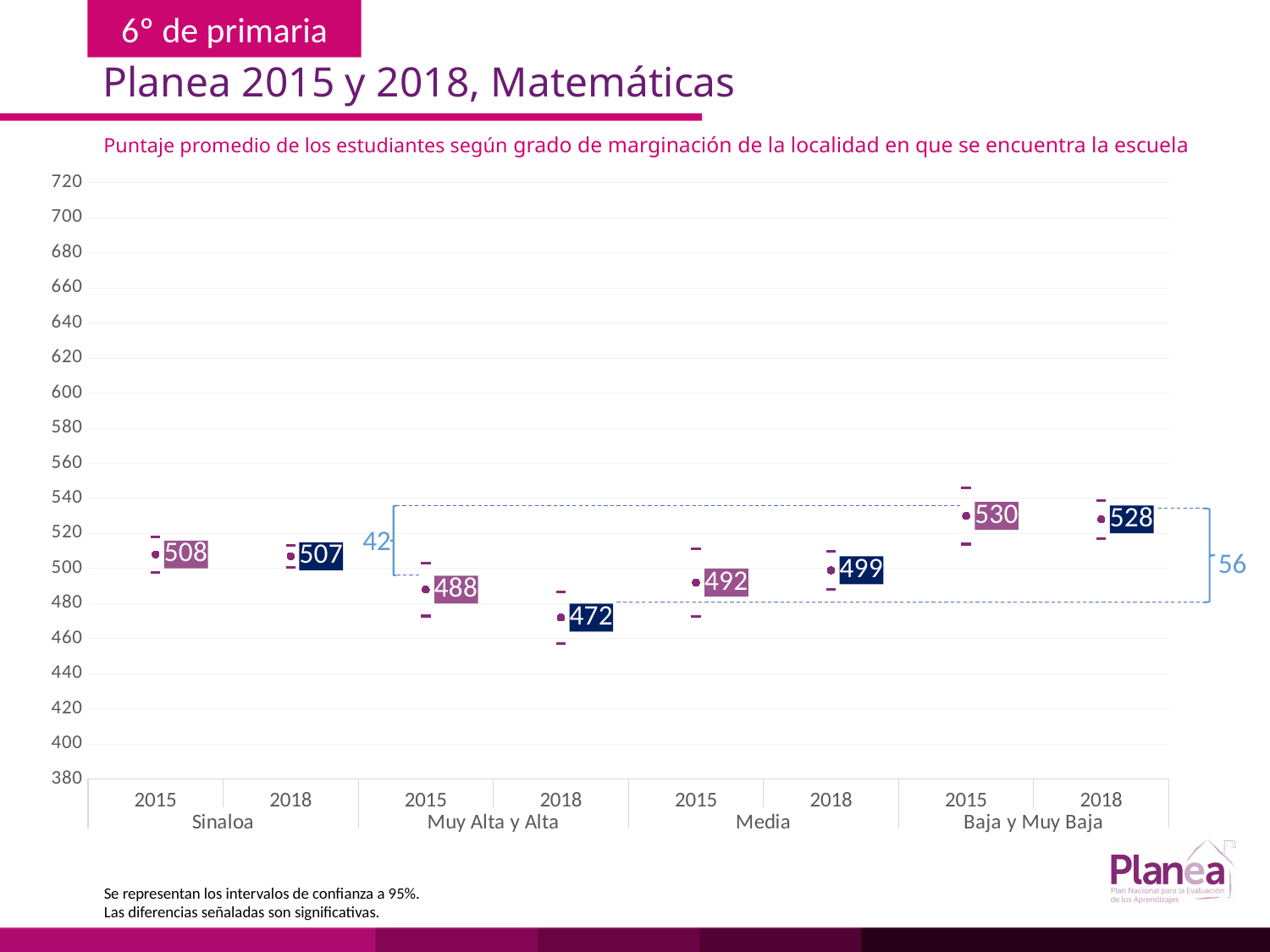
What is the average score for the Media group in 2018? 499 What is the difference between the 2015 scores of the Baja y Muy Baja group and the Muy Alta y Alta group? 42 How many data points are plotted on the chart? 8 What is the average score for the Muy Alta y Alta marginación group in 2018? 472 What is the difference between the 2018 scores of the Baja y Muy Baja group and the Muy Alta y Alta group? 56 Which group and year has the lowest average score? Muy Alta y Alta, 2018 (472) Did the score for the Muy Alta y Alta group rise or fall from 2015 to 2018? fall Which group and year has the highest average score? Baja y Muy Baja, 2015 (530) Is the 2018 score for the Muy Alta y Alta group greater or less than 480? less What is the average score for the Baja y Muy Baja group in 2015? 530 What is the average score for Sinaloa in 2015? 508 Which is larger, the Media group's score in 2015 or in 2018? 2018 (499)